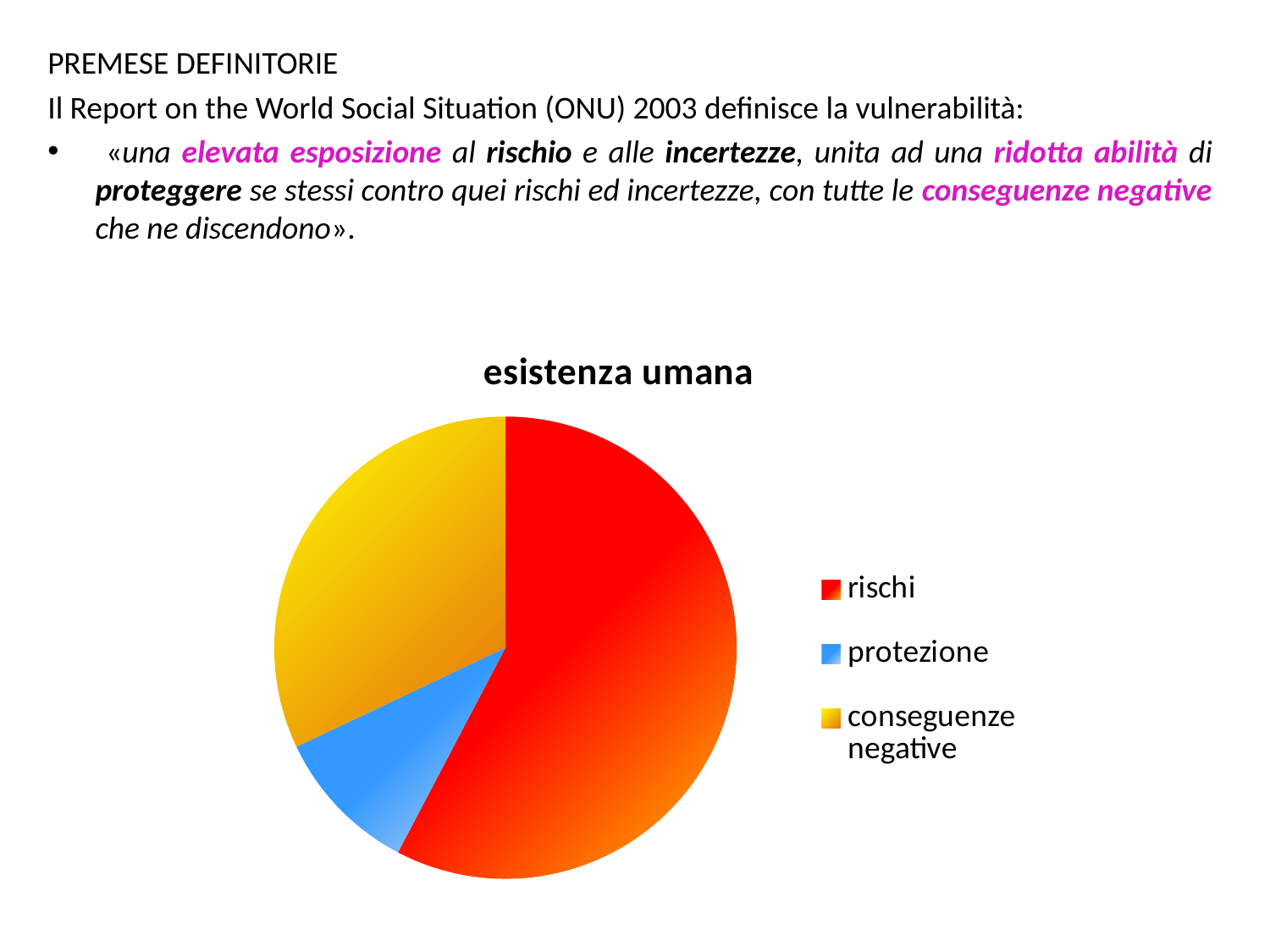
What kind of chart is shown on the slide? pie chart What is the title of the chart? esistenza umana What colour is the slice for protezione? blue Which category has the largest slice of the pie? rischi Which slice is larger, rischi or conseguenze negative? rischi Which slice is smaller, rischi or protezione? protezione Which slice is larger, protezione or conseguenze negative? conseguenze negative How many entries does the chart legend list? 3 How many slices does the pie chart have? 3 Which category has the smallest slice of the pie? protezione